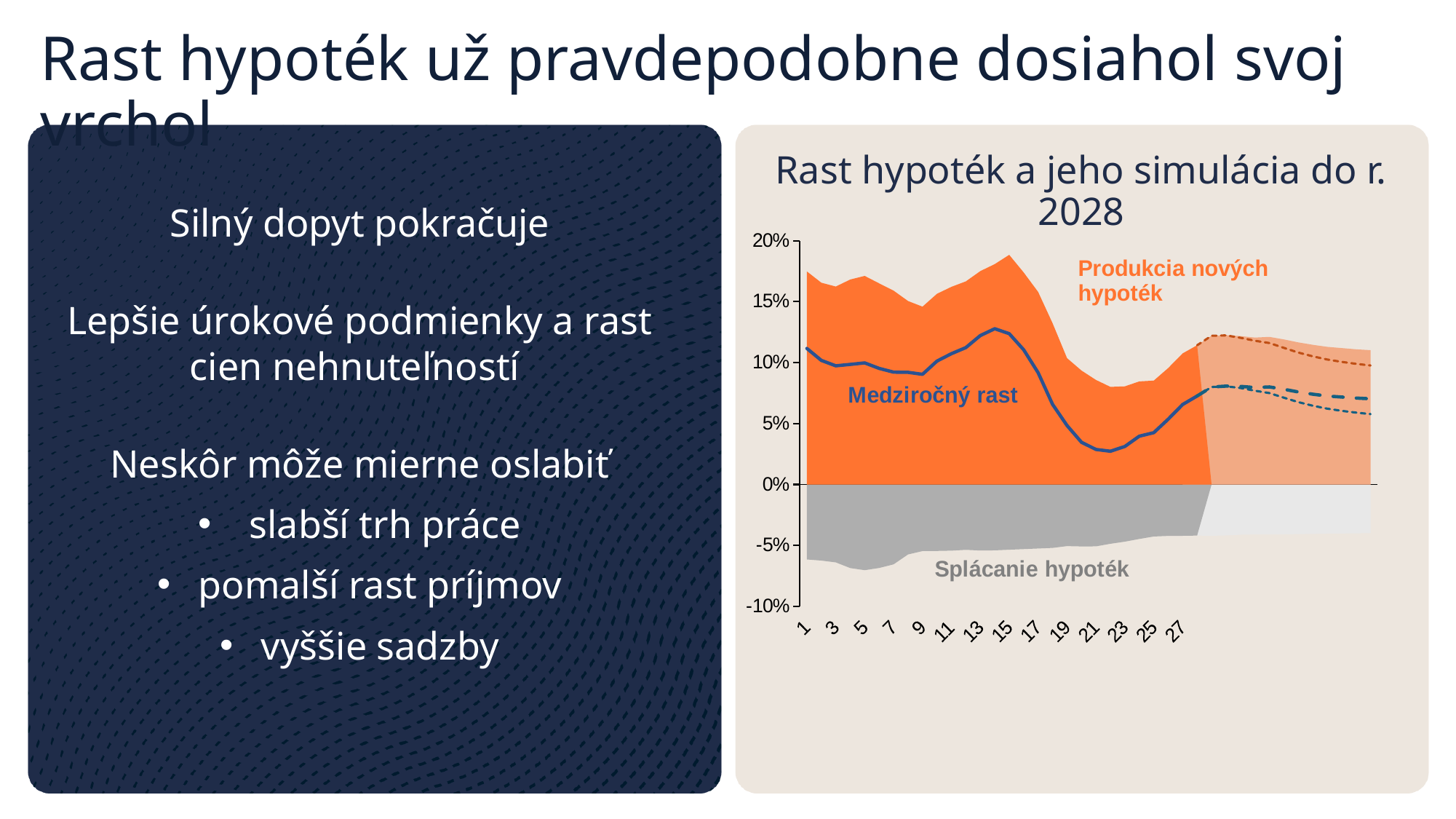
Does Medziročný rast rise or fall between x = 15 and x = 21? fall Is the value of Splácanie hypoték at x = 1 greater or less than -5%? less Is the value of Medziročný rast at x = 15 greater or less than 10%? greater Is the value of Medziročný rast at x = 1 greater or less than 10%? greater What kind of chart is shown on the slide? combination area and line chart Which series is drawn as the orange area in the chart? Produkcia nových hypoték Does Produkcia nových hypoték rise or fall between x = 9 and x = 15? rise What is the title of the chart on the slide? Rast hypoték a jeho simulácia do r. 2028 Which of the two is larger at x = 15: Produkcia nových hypoték or Medziročný rast? Produkcia nových hypoték